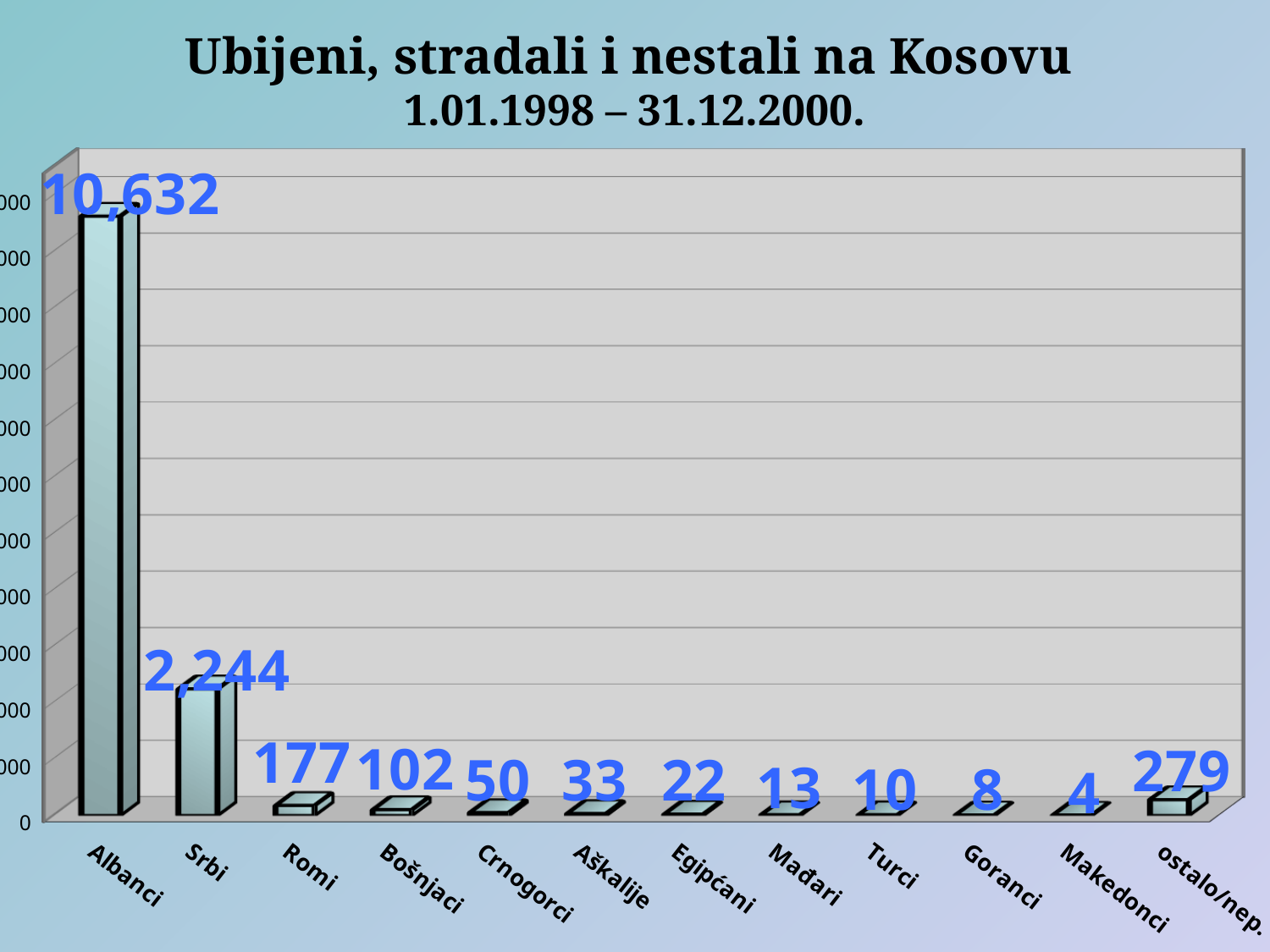
What is the value for ostalo/nep.? 279 Which is larger, the value for Romi or the value for ostalo/nep.? ostalo/nep. What is the value for Romi? 177 What is the title of the chart? Ubijeni, stradali i nestali na Kosovu 1.01.1998 – 31.12.2000. Which category has the highest value? Albanci What is the value for Albanci? 10,632 How many categories are shown on the chart? 12 What kind of chart is shown on the slide? Bar chart What is the value for Srbi? 2,244 What is the difference between the values for Albanci and Srbi? 8,388 What is the value for Makedonci? 4 Which category has the lowest value? Makedonci